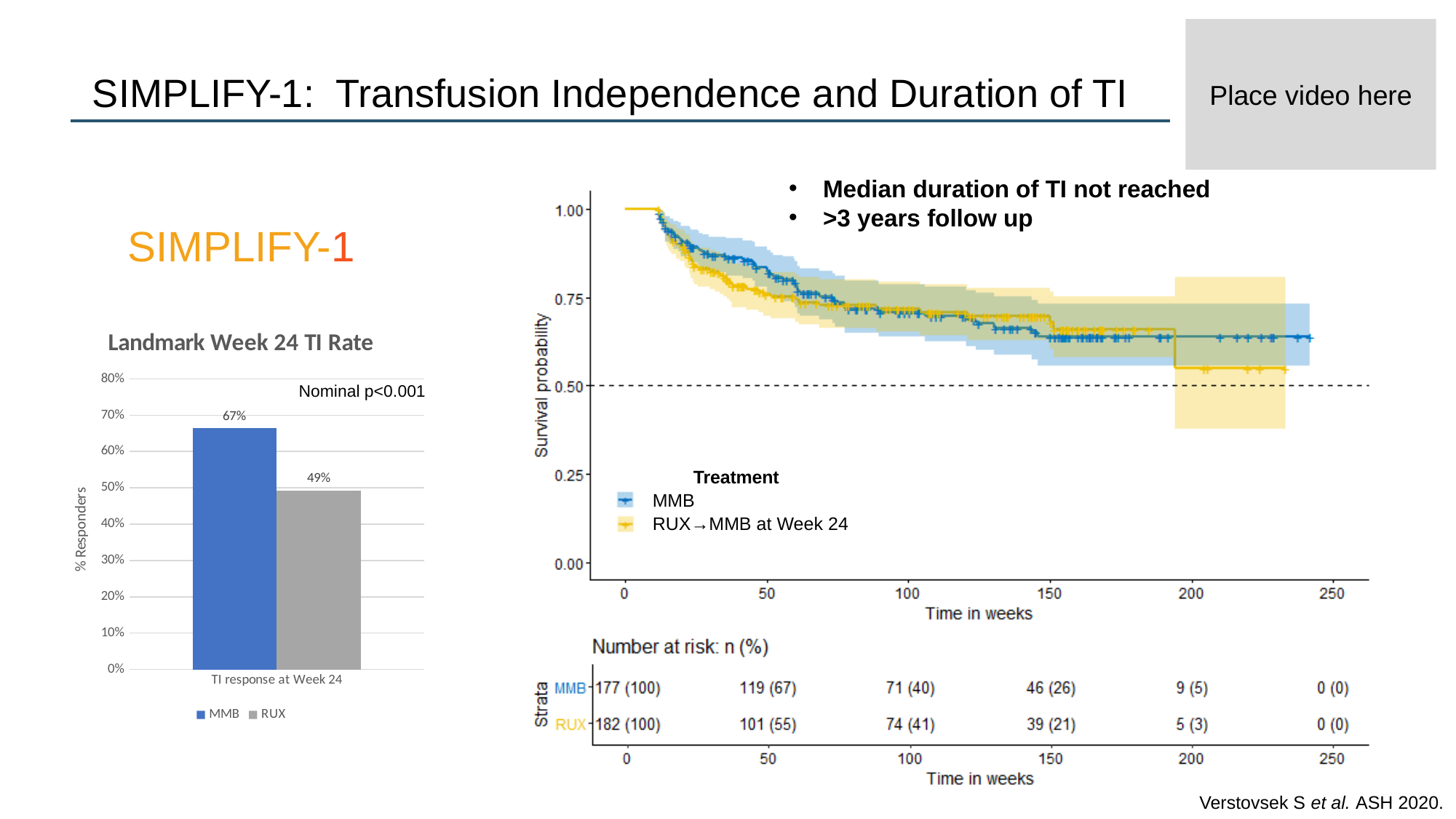
In the 'Landmark Week 24 TI Rate' bar chart, what is the TI response rate at Week 24 for RUX? 49% What kind of chart is the 'Landmark Week 24 TI Rate' chart? Bar chart In the 'Landmark Week 24 TI Rate' bar chart, what is the nominal p-value shown? p<0.001 In the survival probability chart on the right, what is the number at risk for MMB at 0 weeks? 177 (100) In the survival probability chart on the right, is the survival probability for the MMB curve at 200 weeks greater or less than 0.50? greater In the 'Landmark Week 24 TI Rate' bar chart, which treatment has the higher TI response rate? MMB In the 'Landmark Week 24 TI Rate' bar chart, how many series does the legend list? 2 In the survival probability chart on the right, how many treatment groups does the legend list? 2 In the survival probability chart on the right, which group has more patients at risk at 50 weeks, MMB or RUX? MMB In the survival probability chart on the right, what is the number at risk for RUX at 100 weeks? 74 (41) In the 'Landmark Week 24 TI Rate' bar chart, what is the TI response rate at Week 24 for MMB? 67% In the 'Landmark Week 24 TI Rate' bar chart, what is the difference in percentage points between the MMB and RUX response rates? 18 percentage points